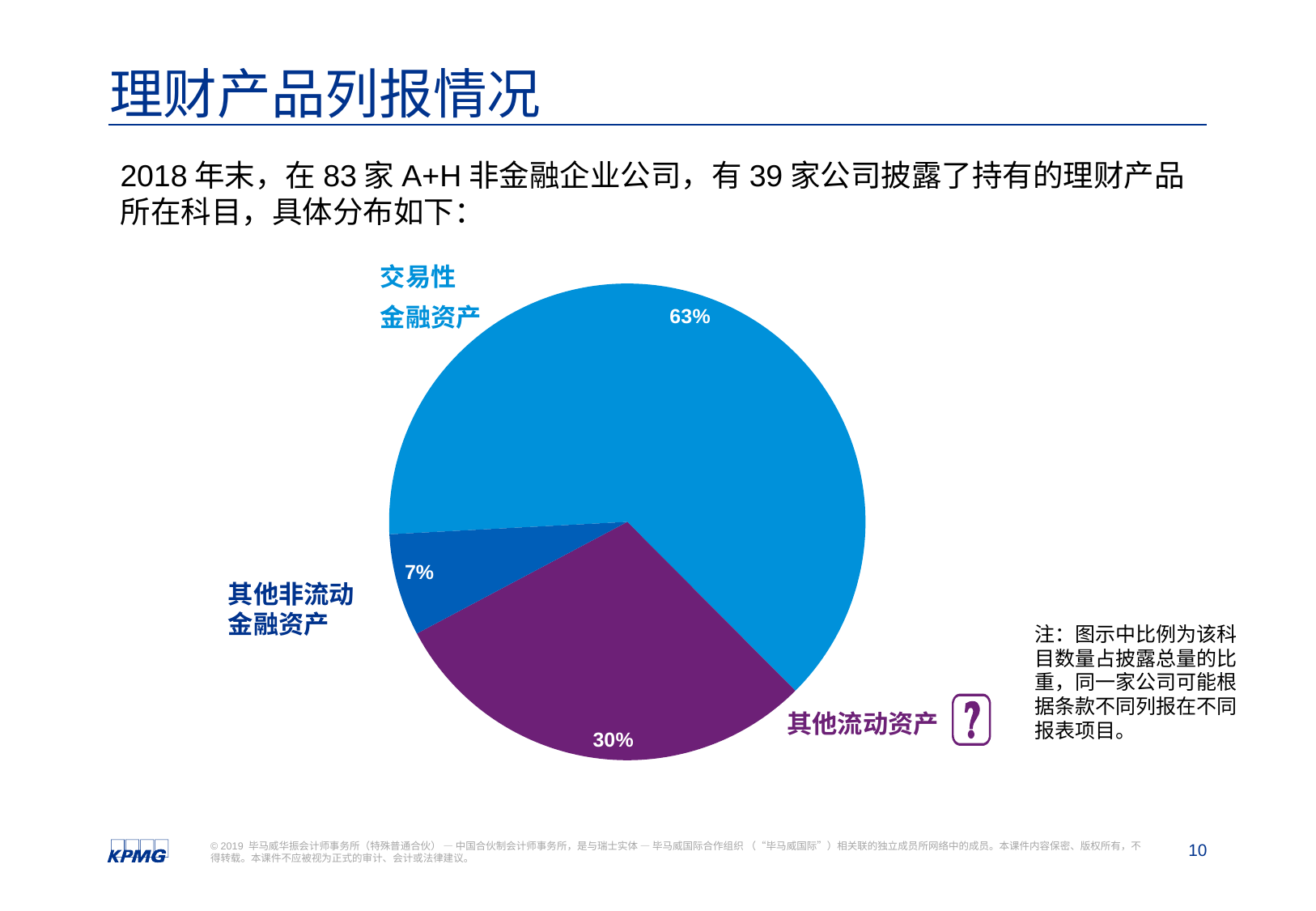
What kind of chart is shown on the slide? pie chart Is the share for 交易性金融资产 greater or less than 50%? greater Which is larger, the slice for 其他流动资产 or the slice for 其他非流动金融资产? 其他流动资产 What share of the pie does 其他流动资产 represent? 30% What share of the pie does 交易性金融资产 represent? 63% What is the difference in percentage points between 交易性金融资产 and 其他流动资产? 33 Which category has the smallest slice of the pie? 其他非流动金融资产 What is the difference in percentage points between 其他流动资产 and 其他非流动金融资产? 23 What share of the pie does 其他非流动金融资产 represent? 7% Which category has the largest slice of the pie? 交易性金融资产 What colour is the slice for 其他流动资产? purple How many slices does the pie chart have? 3